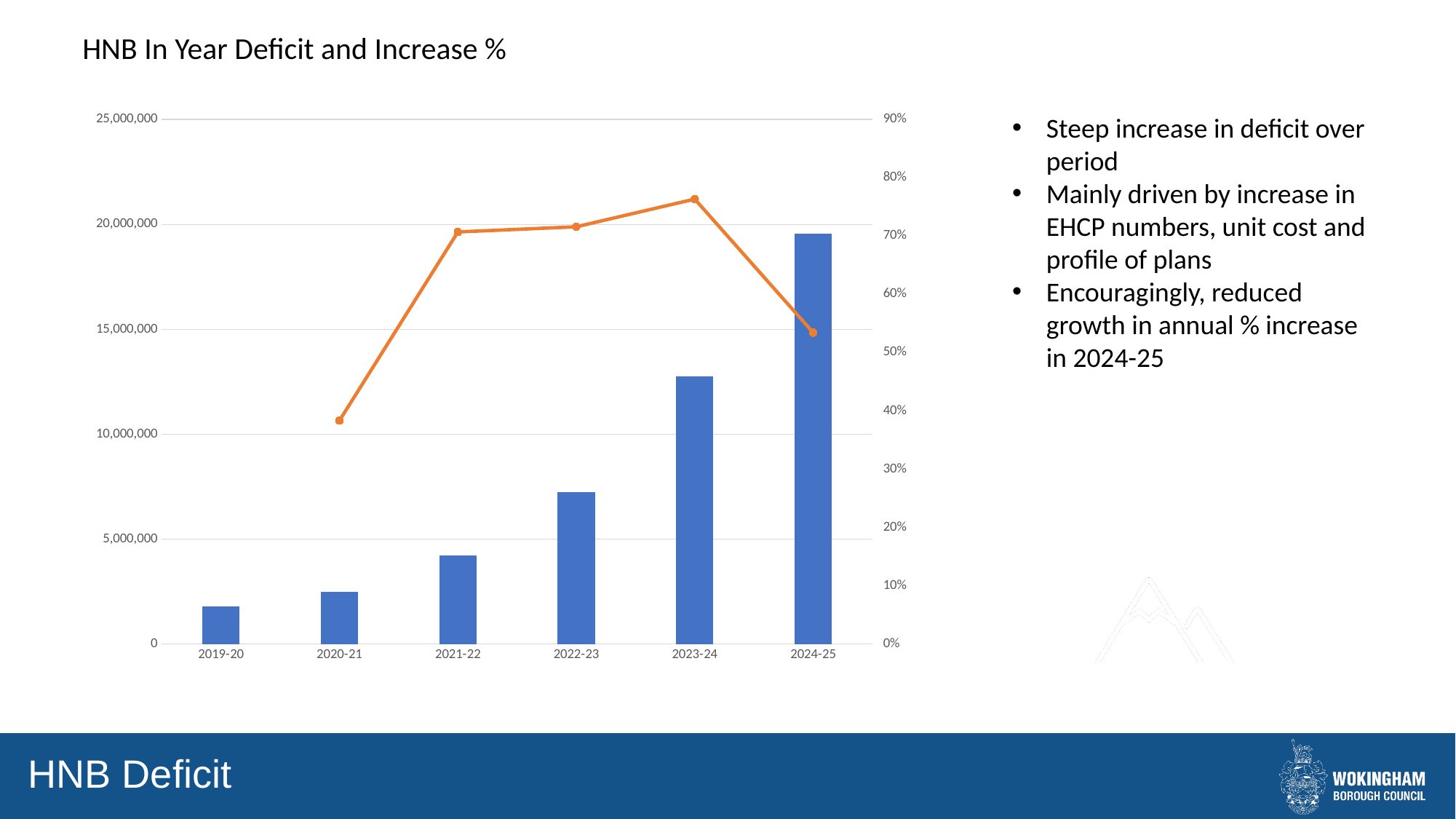
Is the deficit bar for 2024-25 greater or less than 15,000,000? greater How many financial years are shown on the x axis of the chart? 6 What is the title of the chart? HNB In Year Deficit and Increase % Is the deficit bar for 2023-24 greater or less than 10,000,000? greater Which is larger, the deficit bar for 2022-23 or the deficit bar for 2021-22? 2022-23 Do the deficit bars rise or fall from 2019-20 to 2024-25? Rise In which year does the increase % line reach its highest point? 2023-24 What type of chart is shown on the slide? A combined bar and line chart Is the increase % for 2020-21 greater or less than 50%? less Which year has the shortest deficit bar? 2019-20 Which year has the tallest deficit bar? 2024-25